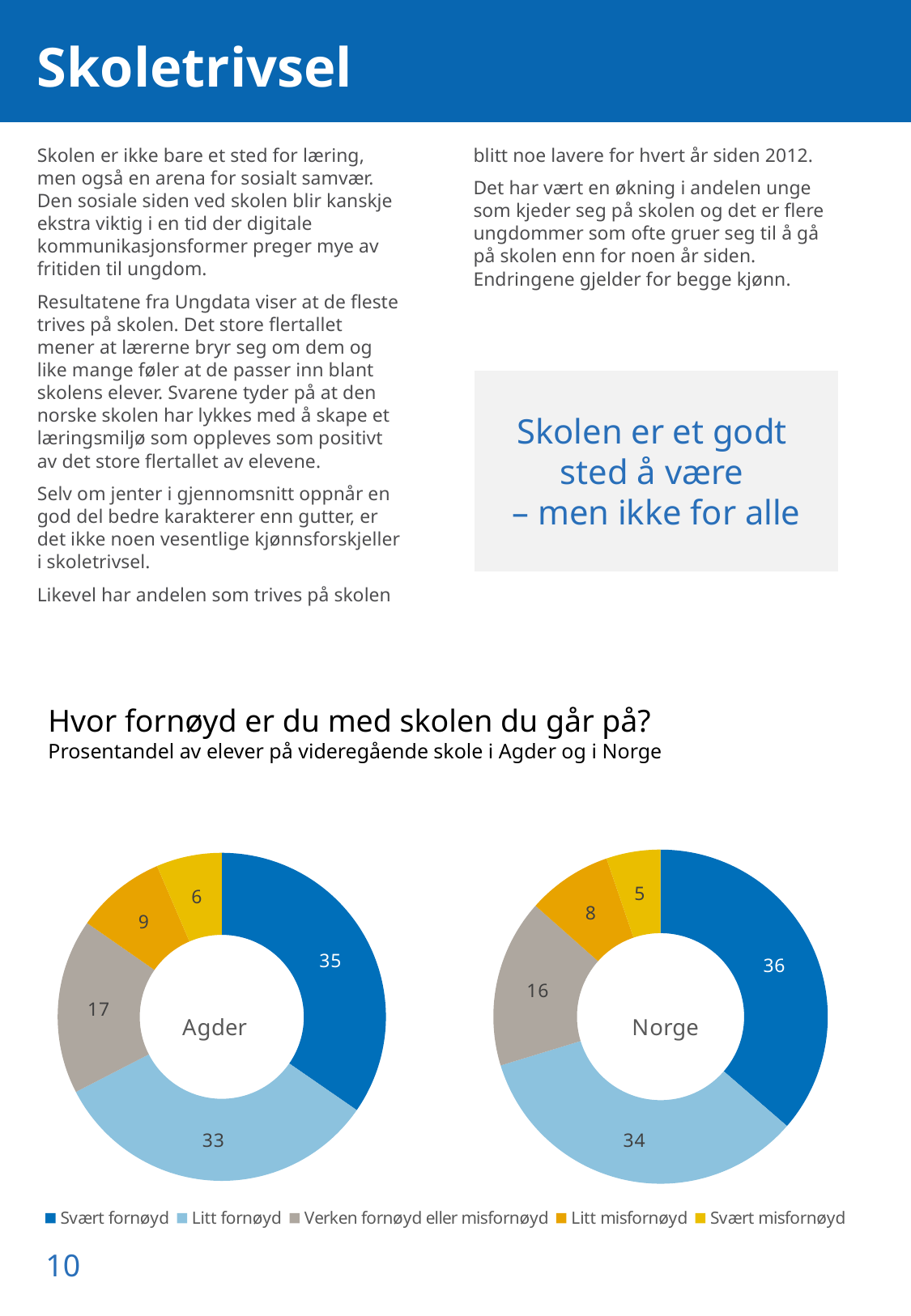
In the Norge chart, what is the value for "Svært misfornøyd"? 5 Which is larger: "Verken fornøyd eller misfornøyd" in the Agder chart or in the Norge chart? Agder What kind of chart is used to show the Agder and Norge data? Doughnut (pie) chart In the Agder chart, what is the difference between "Svært fornøyd" and "Litt misfornøyd"? 26 In the Agder chart, what is the value for "Verken fornøyd eller misfornøyd"? 17 In the Agder chart, which category has the smallest share? Svært misfornøyd In the Norge chart, what percentage of pupils answered "Litt fornøyd"? 34 In the Norge chart, what is the combined share of "Litt misfornøyd" and "Svært misfornøyd"? 13 In the Agder chart, what percentage of pupils answered "Svært fornøyd"? 35 How many categories does the legend list for the charts? 5 In the Norge chart, which category has the largest share? Svært fornøyd What is the title of the chart section on the slide? Hvor fornøyd er du med skolen du går på?